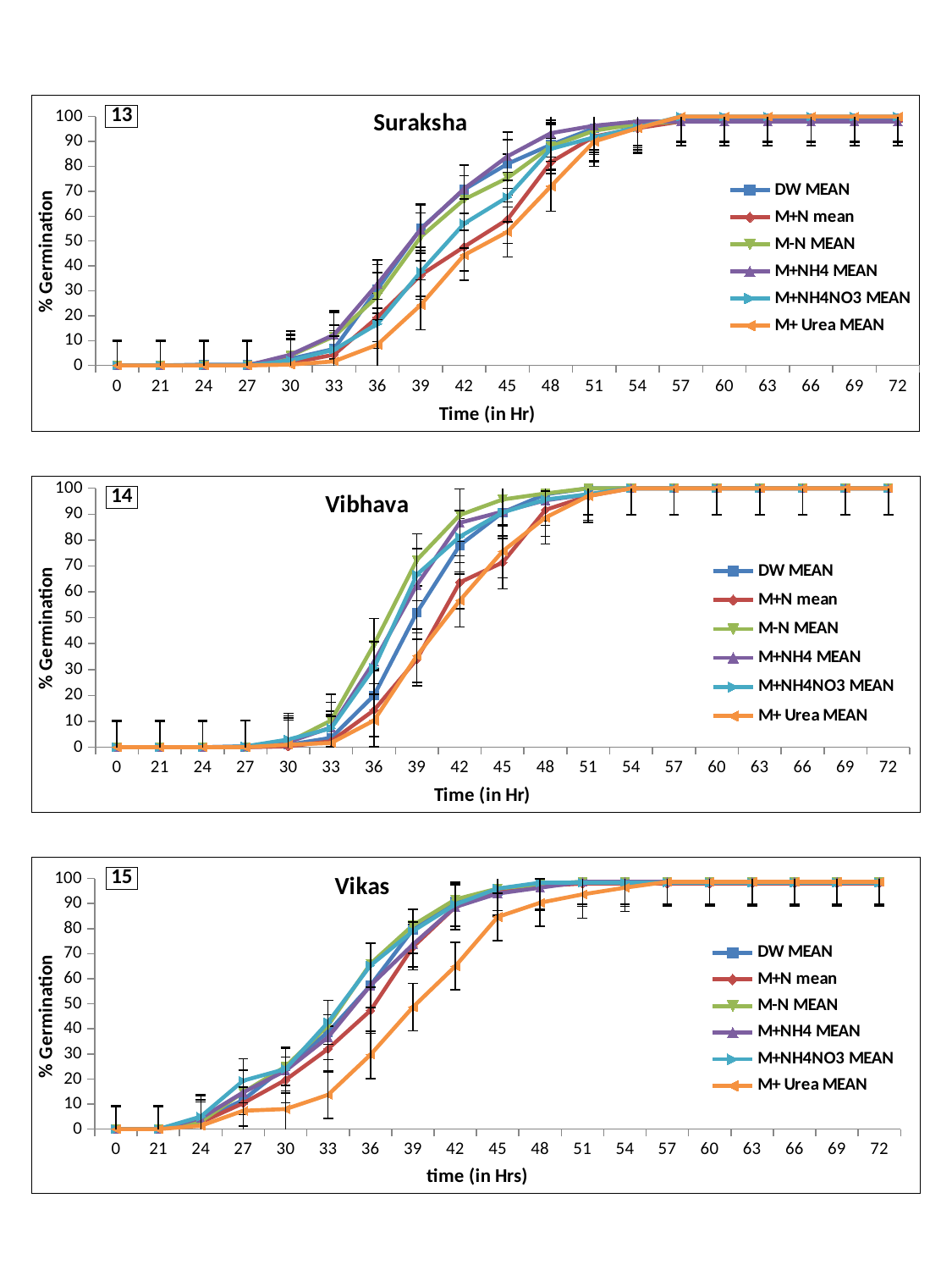
In the Vibhava chart, how many series does the legend list? 6 In the Vikas chart, is the value for M+ Urea MEAN at 42 hr greater or less than 50? greater In the Vikas chart, which series has the lowest value at 42 hr? M+ Urea MEAN In the Suraksha chart, is the value for M+ Urea MEAN at 39 hr greater or less than 40? less In the Suraksha chart, does % germination rise or fall as time increases? Rise In the Suraksha chart, at 45 hr, which is larger: M+NH4 MEAN or M+ Urea MEAN? M+NH4 MEAN What number appears in the box at the top-left of the Vibhava chart? 14 What is the x-axis title of the Vikas chart? time (in Hrs) In the Suraksha chart, what kind of chart is shown? Line chart In the Vibhava chart, is the value for M-N MEAN at 39 hr greater or less than 60? greater In the Vikas chart, at 39 hr, which is larger: M+ Urea MEAN or M-N MEAN? M-N MEAN In the Vikas chart, how many time points are marked on the x axis? 19